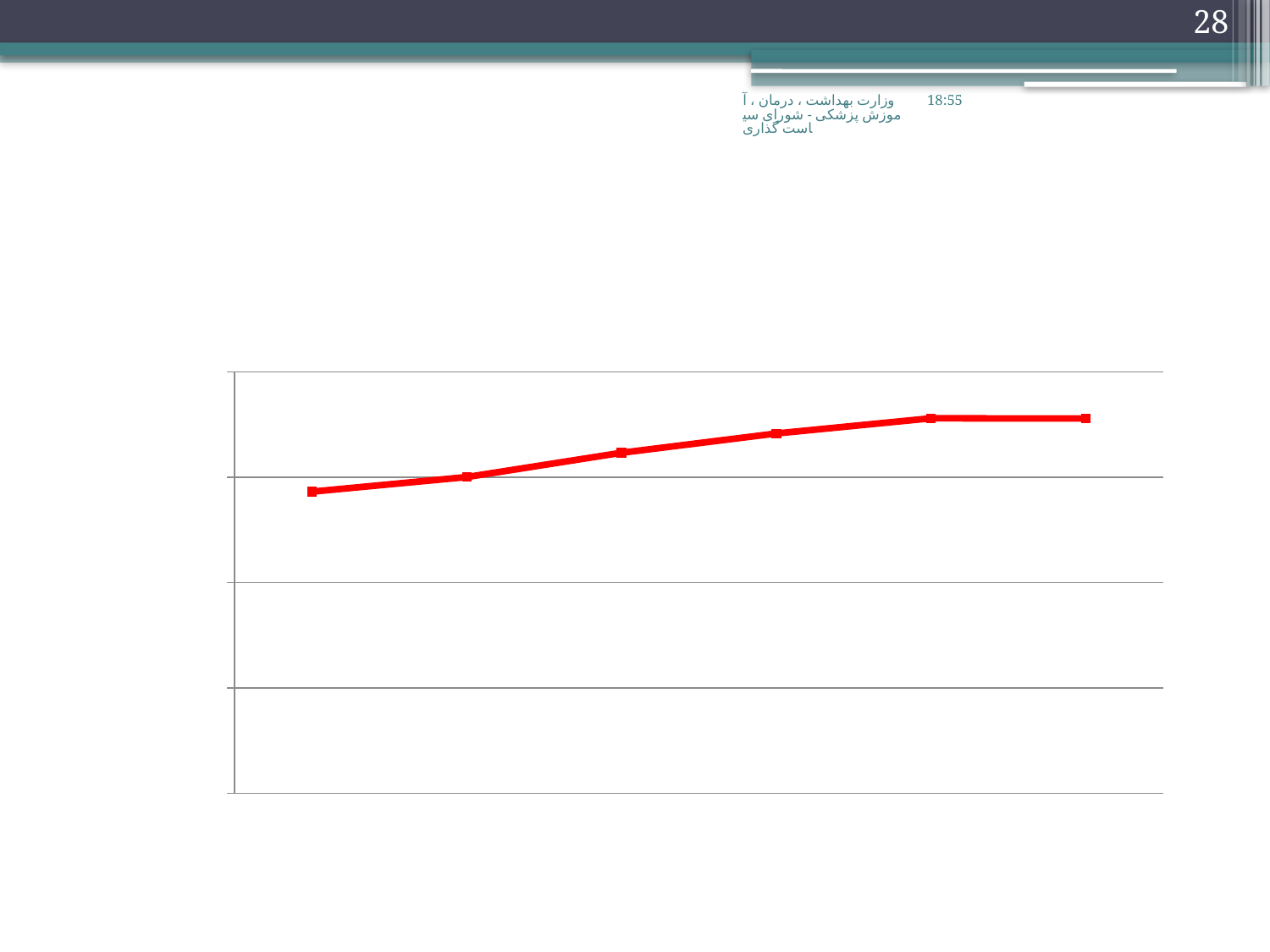
Do the values on the line chart generally rise or fall from left to right? rise What kind of chart is shown on the slide? line chart How many lines (series) are plotted on the chart? 1 What colour is the line plotted on the chart? red How many data points are plotted on the line in the chart? 6